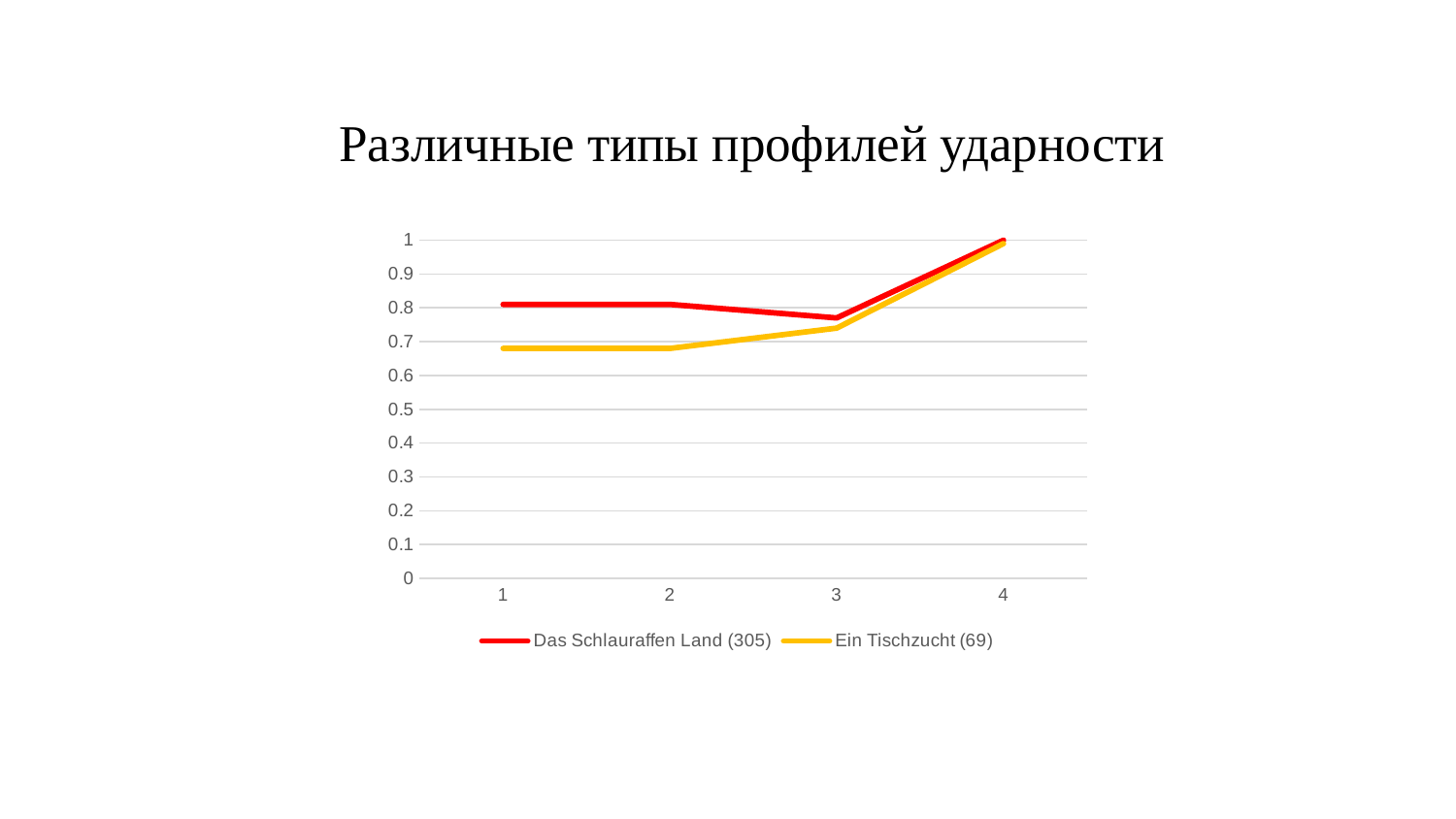
At which x-axis point does Ein Tischzucht (69) reach its highest value? 4 At point 2, which series has the larger value, Das Schlauraffen Land (305) or Ein Tischzucht (69)? Das Schlauraffen Land (305) Is the value for Das Schlauraffen Land (305) at point 4 greater or less than 0.9? greater Is the value for Ein Tischzucht (69) at point 1 greater or less than 0.8? less How many points are plotted along the x axis for each series? 4 At which x-axis point does Das Schlauraffen Land (305) reach its lowest value? 3 Does the Ein Tischzucht (69) line rise or fall from point 3 to point 4? rise Is the value for Das Schlauraffen Land (305) at point 1 greater or less than 0.7? greater Which colour is used for the Ein Tischzucht (69) series? yellow What kind of chart is shown on the slide? line chart How many series does the legend list? 2